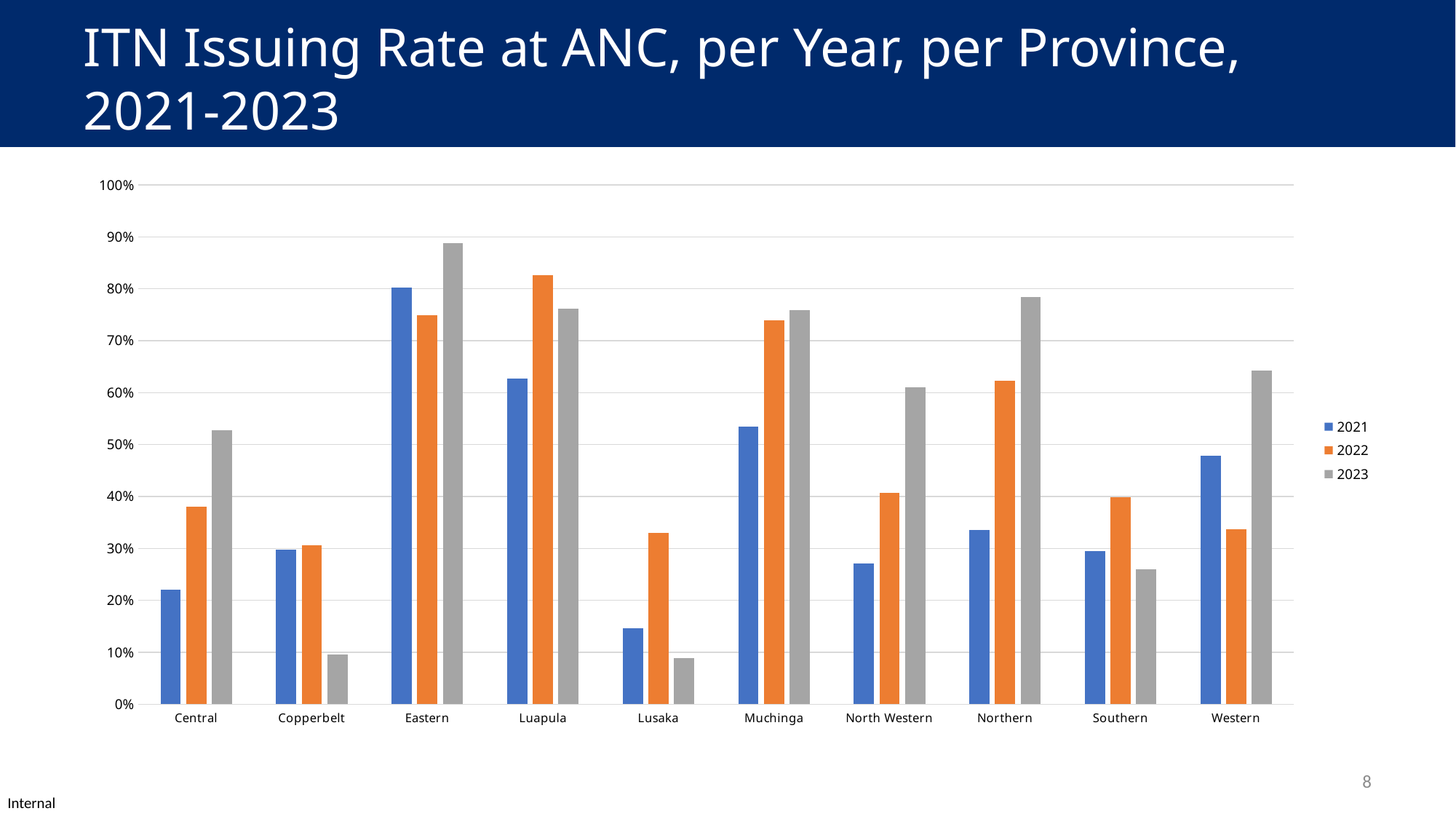
What kind of chart is shown on the slide? bar chart How many provinces are shown on the x axis of the chart? 10 Is the 2023 value for Lusaka greater or less than 10%? less Is the 2022 value for Northern greater or less than 60%? greater Do the values for Central rise or fall from 2021 to 2023? rise Is the 2023 value for Eastern greater or less than 80%? greater Which province has the highest 2022 ITN issuing rate? Luapula Which province has the lowest 2021 ITN issuing rate? Lusaka For Western, which year has the larger ITN issuing rate, 2021 or 2022? 2021 Which province has the highest 2023 ITN issuing rate? Eastern How many series does the legend list? 3 For Luapula, which year has the larger ITN issuing rate, 2021 or 2022? 2022